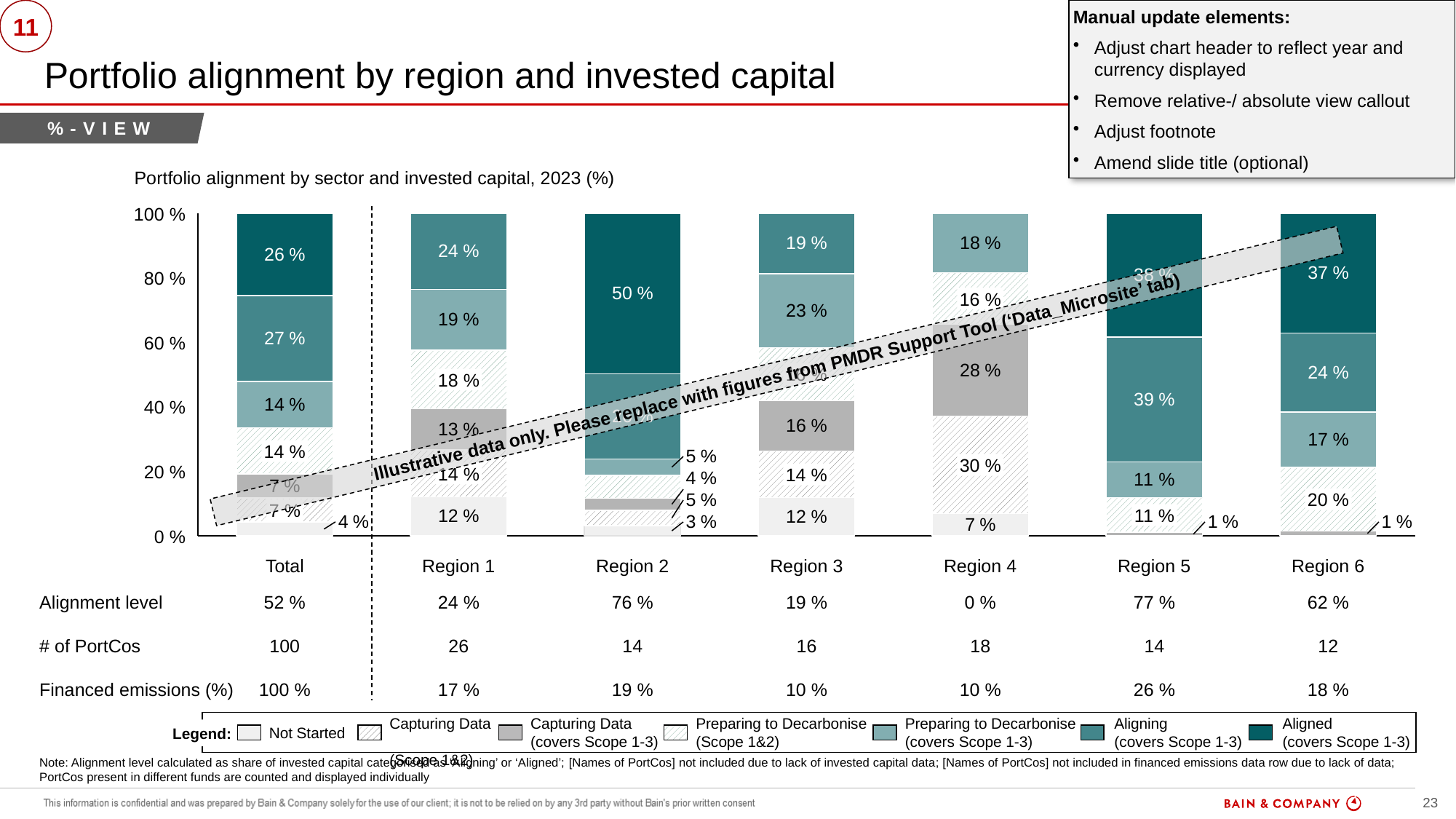
Which region has the largest 'Aligned (covers Scope 1-3)' segment? Region 2 What is the title of the chart? Portfolio alignment by sector and invested capital, 2023 (%) What is the 'Aligned (covers Scope 1-3)' share for the Total bar? 26 % What kind of chart is shown on the slide? Stacked bar chart How many series does the chart legend list? 7 How many categories (bars) are shown along the x axis of the chart? 7 Which has the larger 'Aligning (covers Scope 1-3)' share, Region 5 or Region 6? Region 5 What is the 'Not Started' share for Region 4? 7 % What is the 'Not Started' share for Region 1? 12 % What is the 'Capturing Data (covers Scope 1-3)' share for Region 4? 28 % How much larger is the 'Aligned (covers Scope 1-3)' share for Region 6 than for the Total bar? 11 percentage points What is the 'Aligned (covers Scope 1-3)' share for Region 2? 50 %